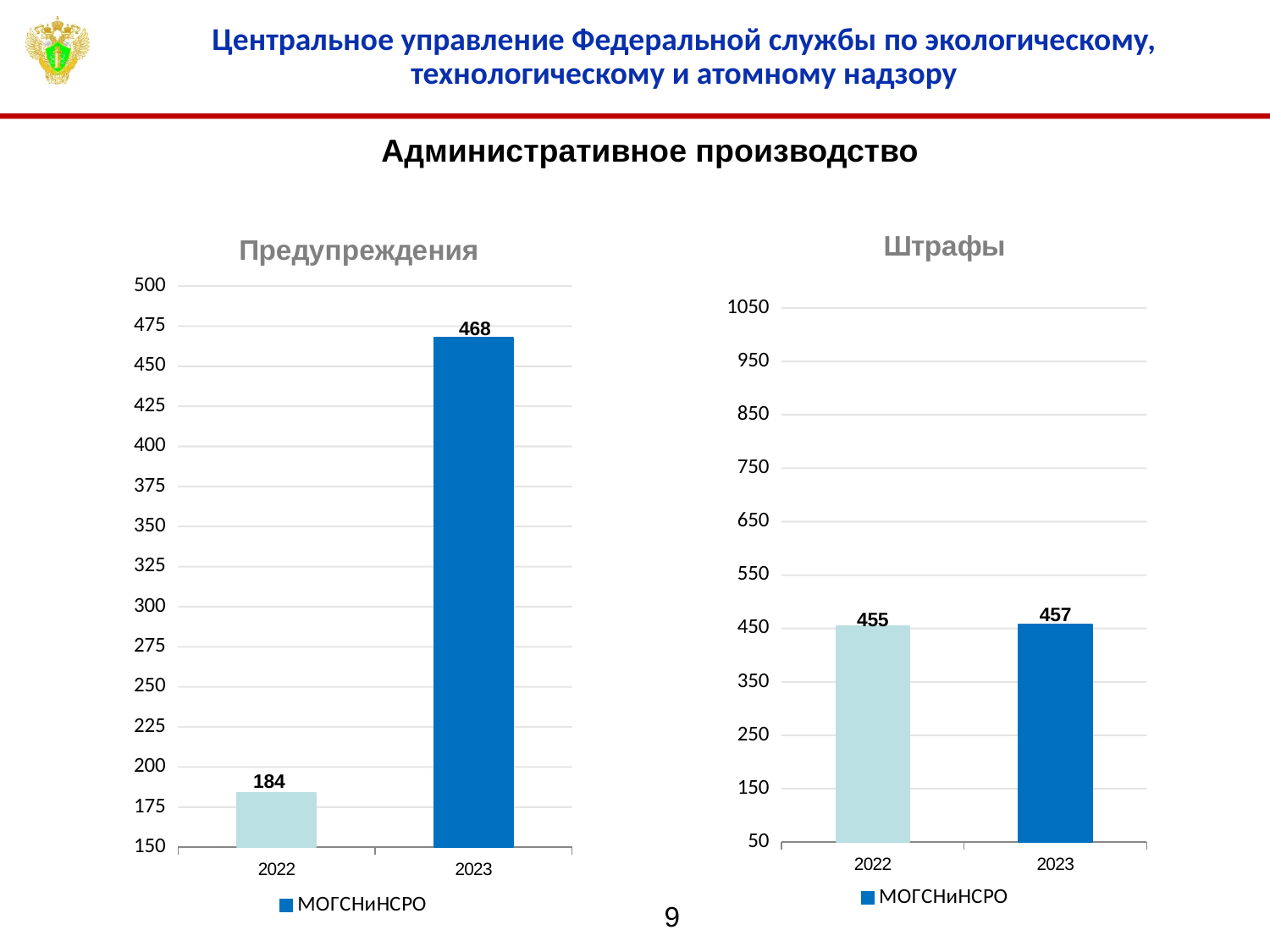
In the 'Штрафы' chart, is the value for 2022 greater or less than 550? less What series name does the legend of the 'Штрафы' chart list? МОГСНиНСРО How many categories are shown on the x axis of the 'Штрафы' chart? 2 What kind of chart is the 'Предупреждения' chart? bar chart In the 'Предупреждения' chart, what is the value for 2023? 468 In the 'Предупреждения' chart, what is the value for 2022? 184 In the 'Предупреждения' chart, which year has the higher value? 2023 In the 'Предупреждения' chart, is the value for 2023 greater or less than 400? greater In the 'Штрафы' chart, what is the value for 2022? 455 In the 'Штрафы' chart, what is the difference between the 2023 and 2022 values? 2 In the 'Штрафы' chart, what is the value for 2023? 457 In the 'Предупреждения' chart, what is the difference between the 2023 and 2022 values? 284